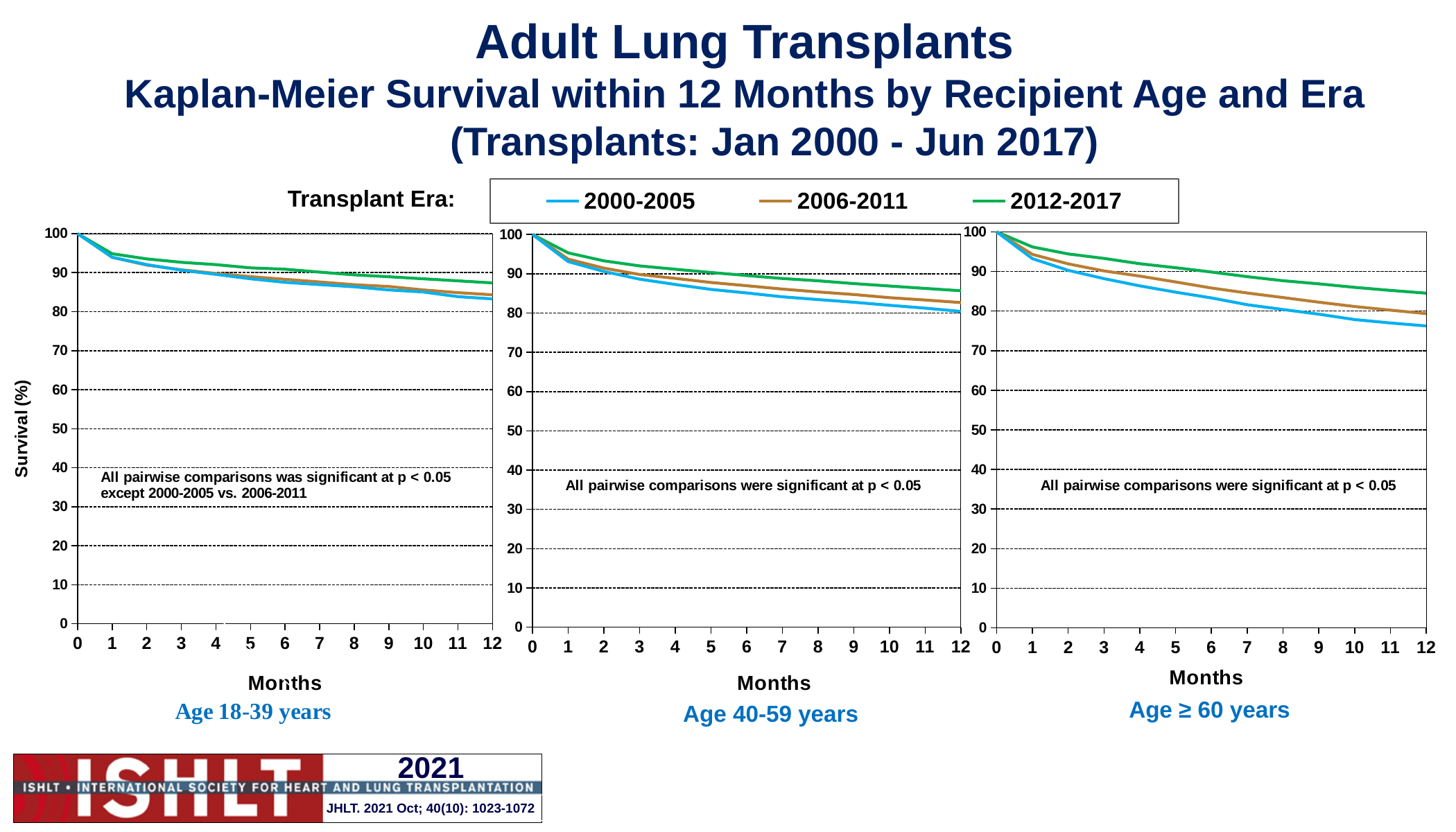
In the Age ≥ 60 years chart, is the 2000-2005 survival at 12 months greater or less than 80? less In the Age ≥ 60 years chart, is the 2012-2017 survival at 12 months greater or less than 80? greater In the Age 40-59 years chart, which is larger at 12 months: survival for 2012-2017 or for 2000-2005? 2012-2017 In the Age 18-39 years chart, what is the survival value for all eras at month 0? 100 How many survival charts (age groups) are shown on the slide? 3 What kind of chart is used in the Age 18-39 years panel? line chart How many transplant era series does the legend list? 3 Which transplant eras are listed in the legend? 2000-2005, 2006-2011, 2012-2017 In the Age ≥ 60 years chart, do the survival curves rise or fall as months increase? fall In the Age ≥ 60 years chart, which transplant era has the highest survival at 12 months? 2012-2017 In the Age 40-59 years chart, is the 2012-2017 survival at 12 months greater or less than 90? less In the Age ≥ 60 years chart, which transplant era has the lowest survival at 12 months? 2000-2005